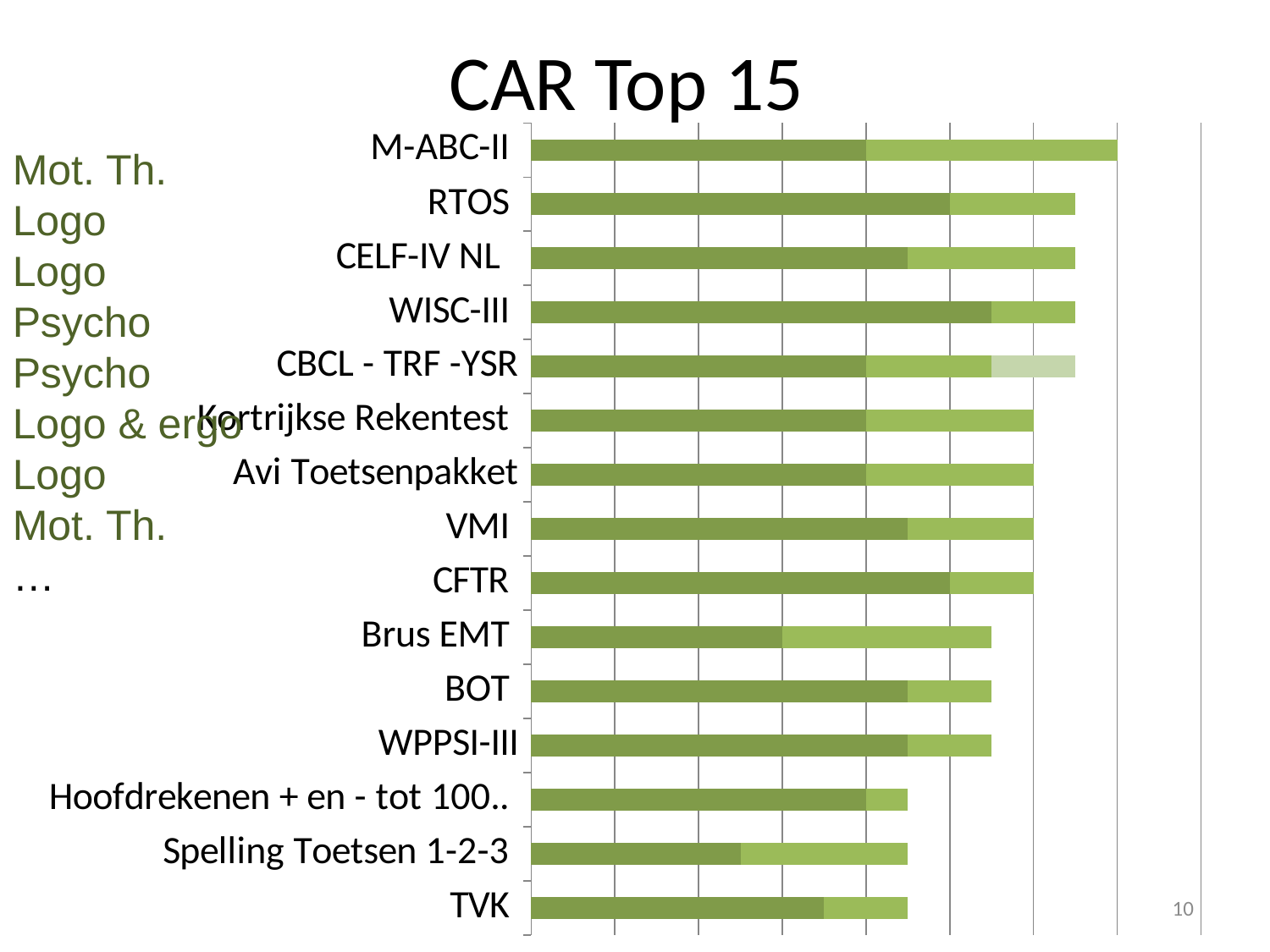
Which category has the longest total bar? M-ABC-II Which category is listed at the bottom of the chart? TVK What is the title of the chart? CAR Top 15 Do the total bar lengths increase or decrease going from the top category to the bottom category? Decrease How many categories (tests) are plotted in the chart? 15 Which has the longer total bar, M-ABC-II or TVK? M-ABC-II Are the bars in the chart horizontal or vertical? Horizontal Which has the longer total bar, WISC-III or Spelling Toetsen 1-2-3? WISC-III Which category is listed at the top of the chart? M-ABC-II Which has the longer total bar, RTOS or Brus EMT? RTOS What kind of chart is shown on the slide? Bar chart